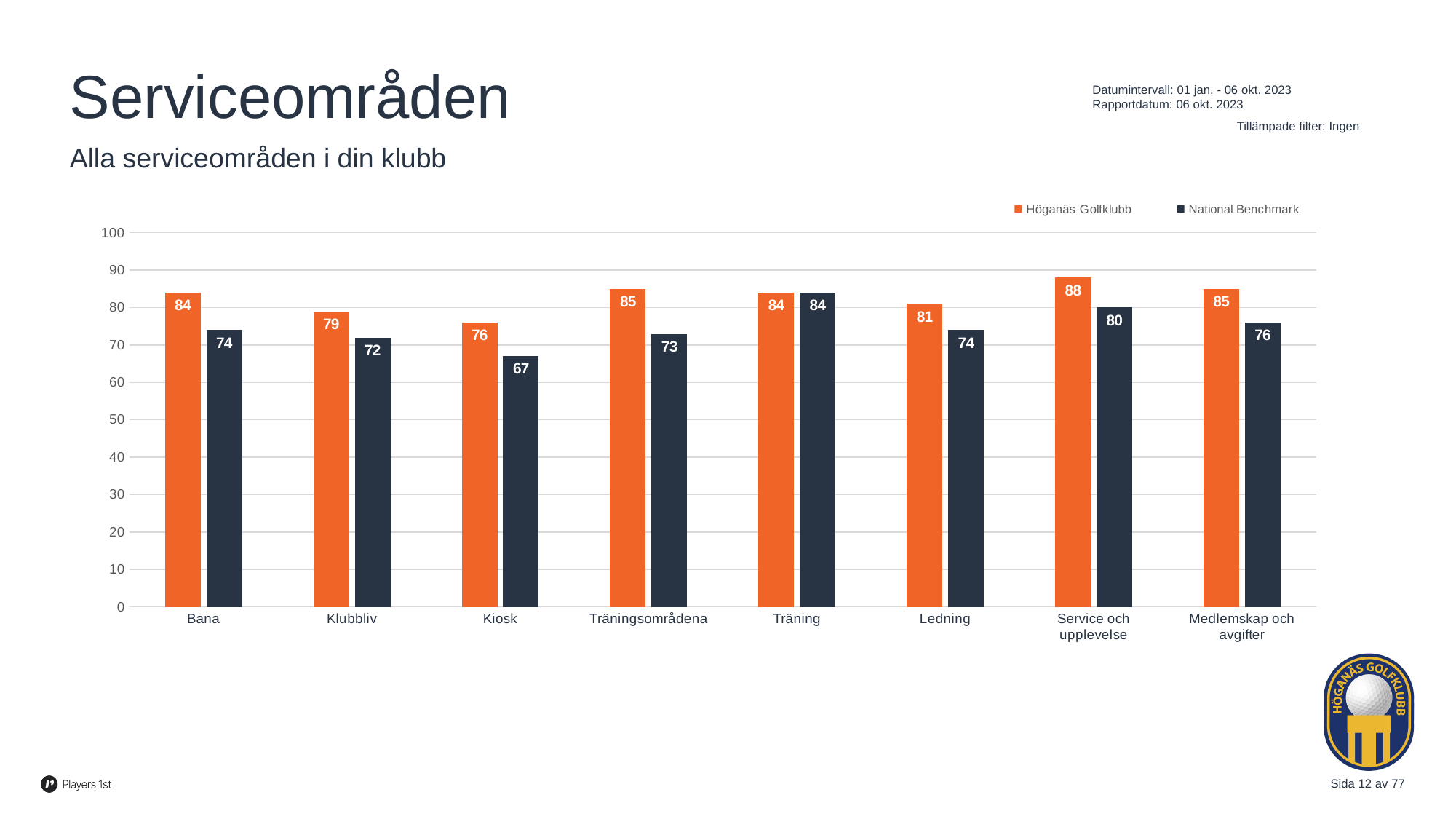
Which category has the lowest National Benchmark value? Kiosk How many series does the legend list? 2 What is the National Benchmark value for Ledning? 74 What is the Höganäs Golfklubb value for Kiosk? 76 What is the difference between the Höganäs Golfklubb and National Benchmark values for Bana? 10 Is the National Benchmark value for Kiosk greater or less than 70? less What kind of chart is shown on the slide? bar chart What is the Höganäs Golfklubb value for Träning? 84 Which category has the highest Höganäs Golfklubb value? Service och upplevelse Which is larger for Klubbliv: the Höganäs Golfklubb value or the National Benchmark value? Höganäs Golfklubb Which colour represents National Benchmark in the legend? dark navy How many categories are shown on the x axis? 8